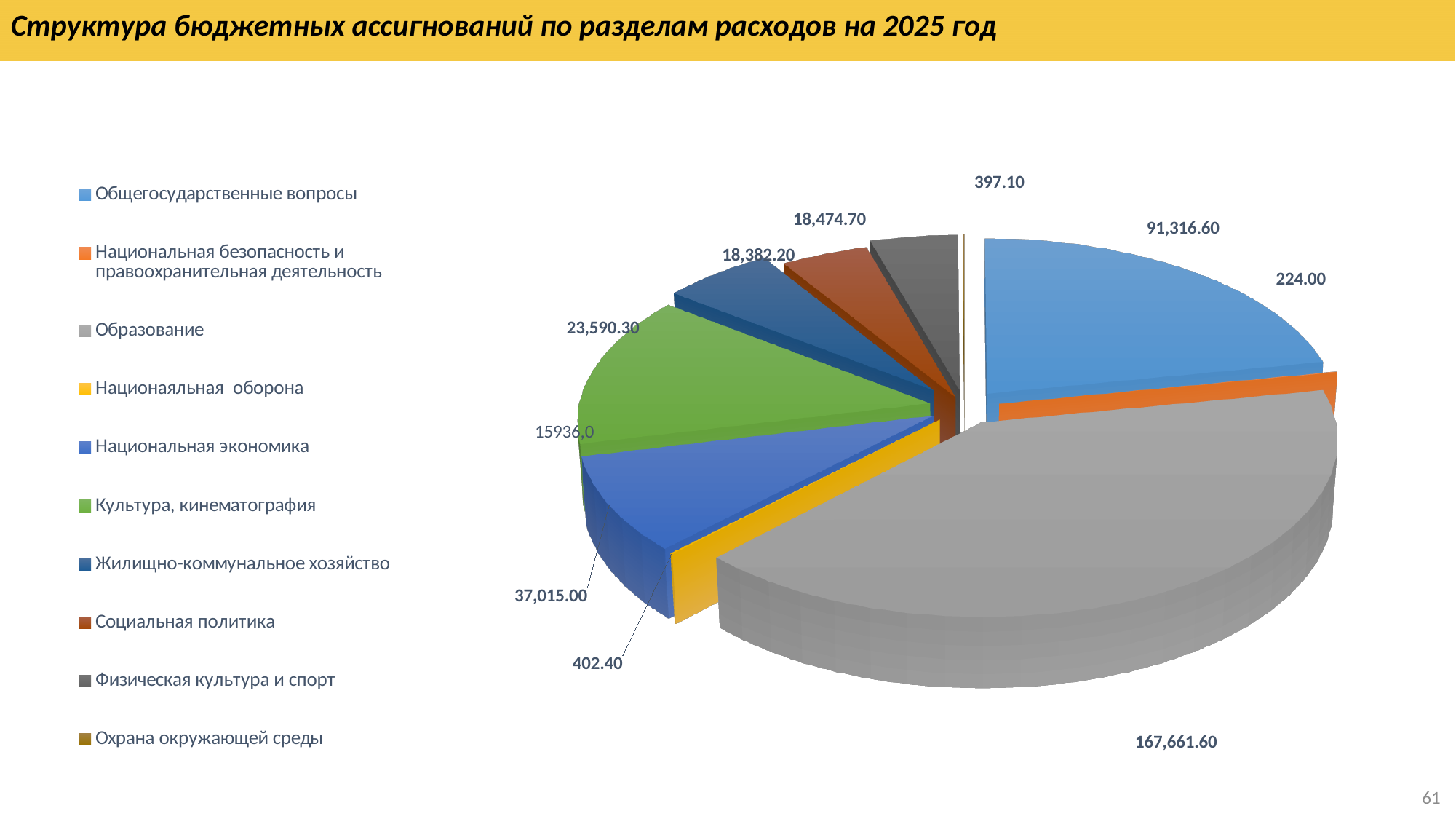
How many categories does the legend of the pie chart list? 10 What is the value shown for Национальная безопасность и правоохранительная деятельность? 224.00 What is the value shown for Национальная экономика? 37,015.00 What kind of chart is shown on the slide? pie chart Which category has the largest slice in the pie chart? Образование What is the difference between the values for Образование and Общегосударственные вопросы? 76,345.00 What is the value shown for Общегосударственные вопросы? 91,316.60 What is the value shown for Образование? 167,661.60 Which is larger, the value for Образование or the value for Общегосударственные вопросы? Образование What is the title of the slide's chart? Структура бюджетных ассигнований по разделам расходов на 2025 год What is the value shown for Национаяльная оборона? 402.40